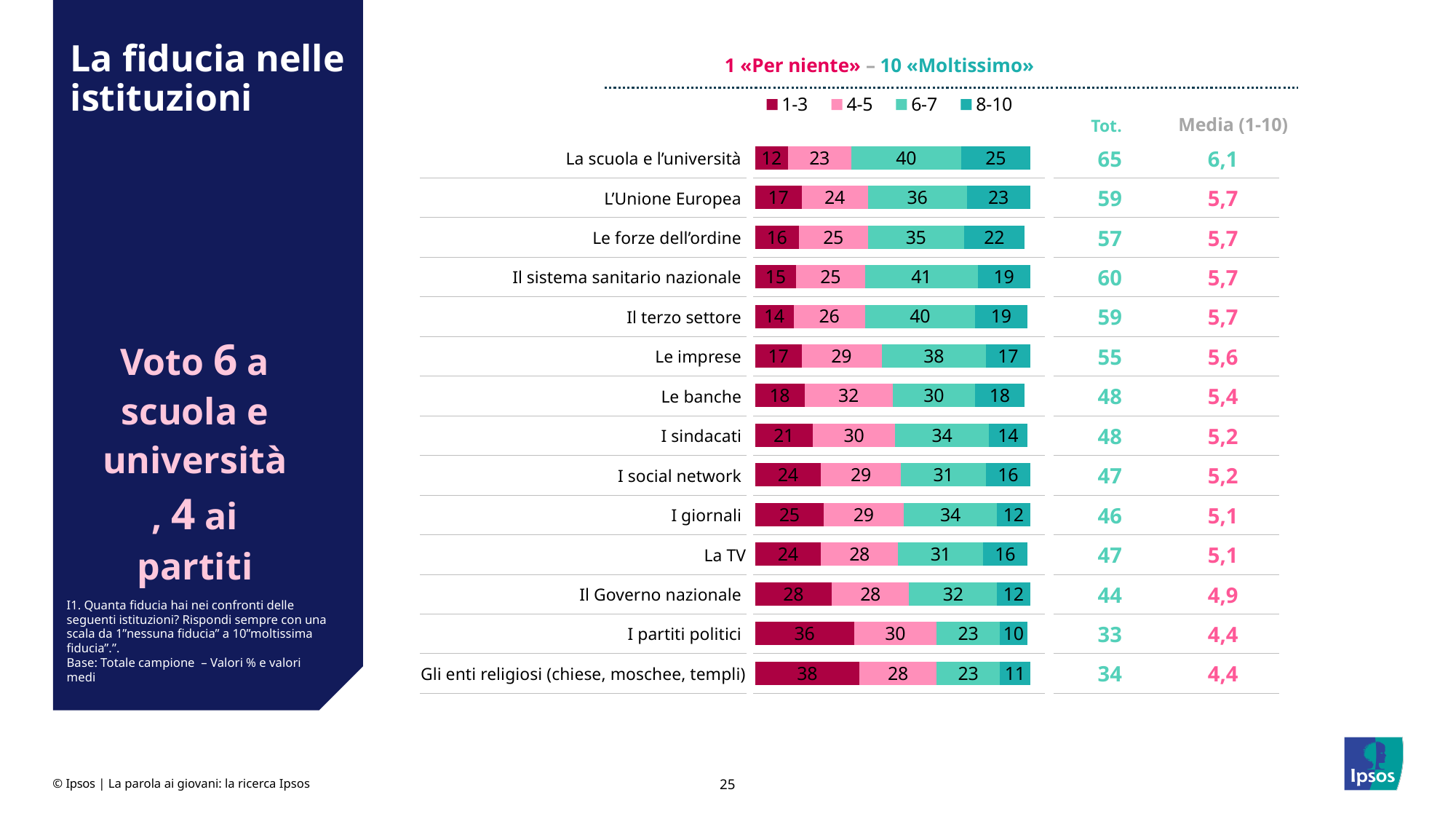
Which category has the lowest value in the 8-10 series? I partiti politici What is the total of the stacked bar for La scuola e l'università? 100 What is the value of the 8-10 segment for La scuola e l'università? 25 What kind of chart is shown on the slide? Stacked bar chart Which category has the highest value in the 1-3 series? Gli enti religiosi (chiese, moschee, templi) How many series does the legend list? 4 What are the legend entries of the chart? 1-3, 4-5, 6-7, 8-10 What is the value of the 1-3 segment for I partiti politici? 36 Which has the larger 4-5 value, Le banche or Le imprese? Le banche What is the value of the 6-7 segment for Le imprese? 38 How many categories (institutions) are shown in the chart? 14 What is the difference between the 6-7 value for Il sistema sanitario nazionale and the 6-7 value for I partiti politici? 18